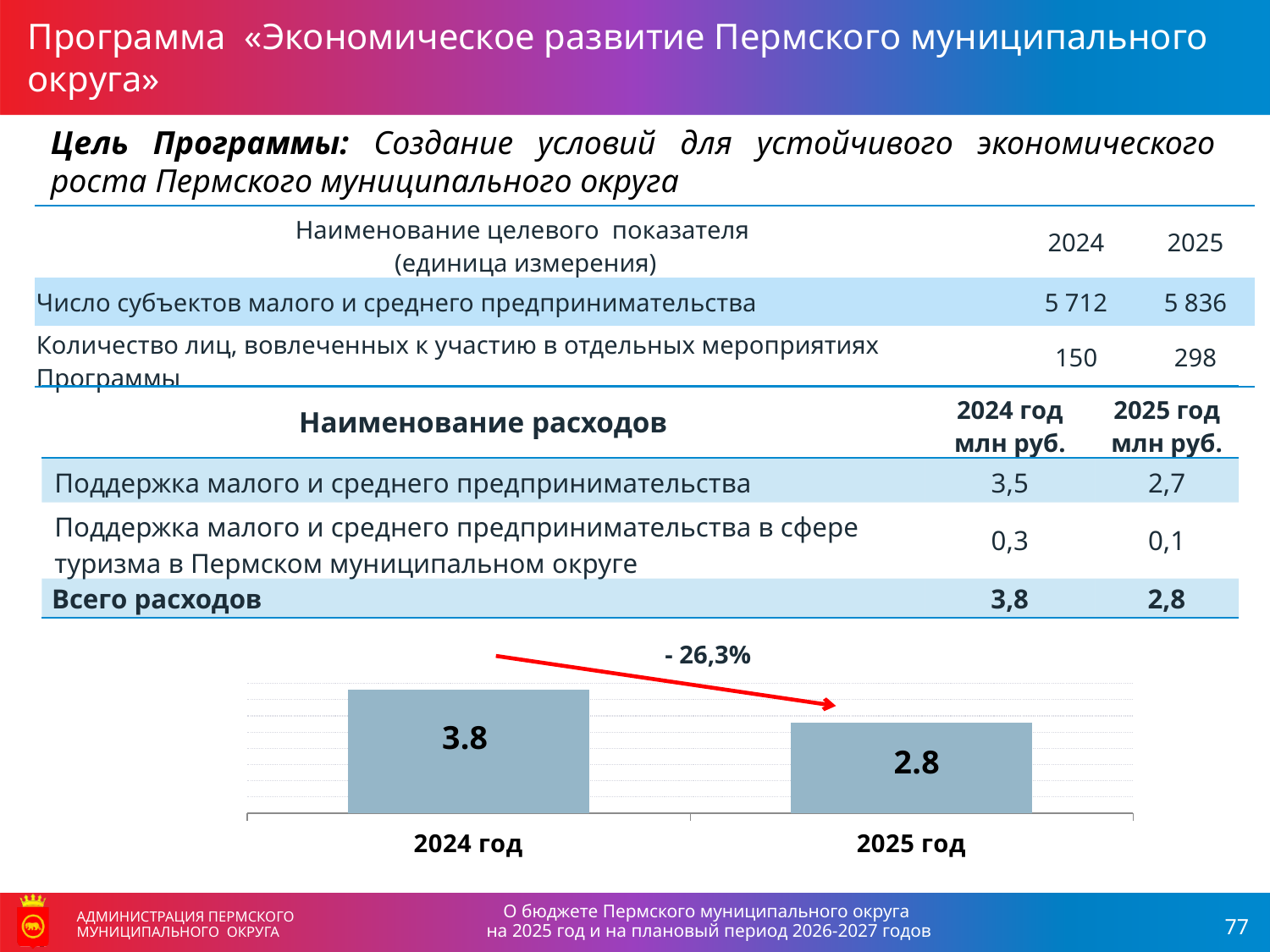
Do the values in the bar chart rise or fall from 2024 год to 2025 год? fall What is the value shown for 2024 год in the bar chart? 3.8 Is the value for 2024 год larger or smaller than the value for 2025 год in the bar chart? larger Which year has the lower bar in the chart? 2025 год What kind of chart is shown at the bottom of the slide? bar chart What is the difference between the 2024 год and 2025 год values in the bar chart? 1.0 What are the two category labels on the x axis of the bar chart? 2024 год, 2025 год What is the value shown for 2025 год in the bar chart? 2.8 How many bars are plotted in the chart? 2 What percentage change is annotated above the bars in the chart? - 26,3% Which year has the higher bar in the chart? 2024 год